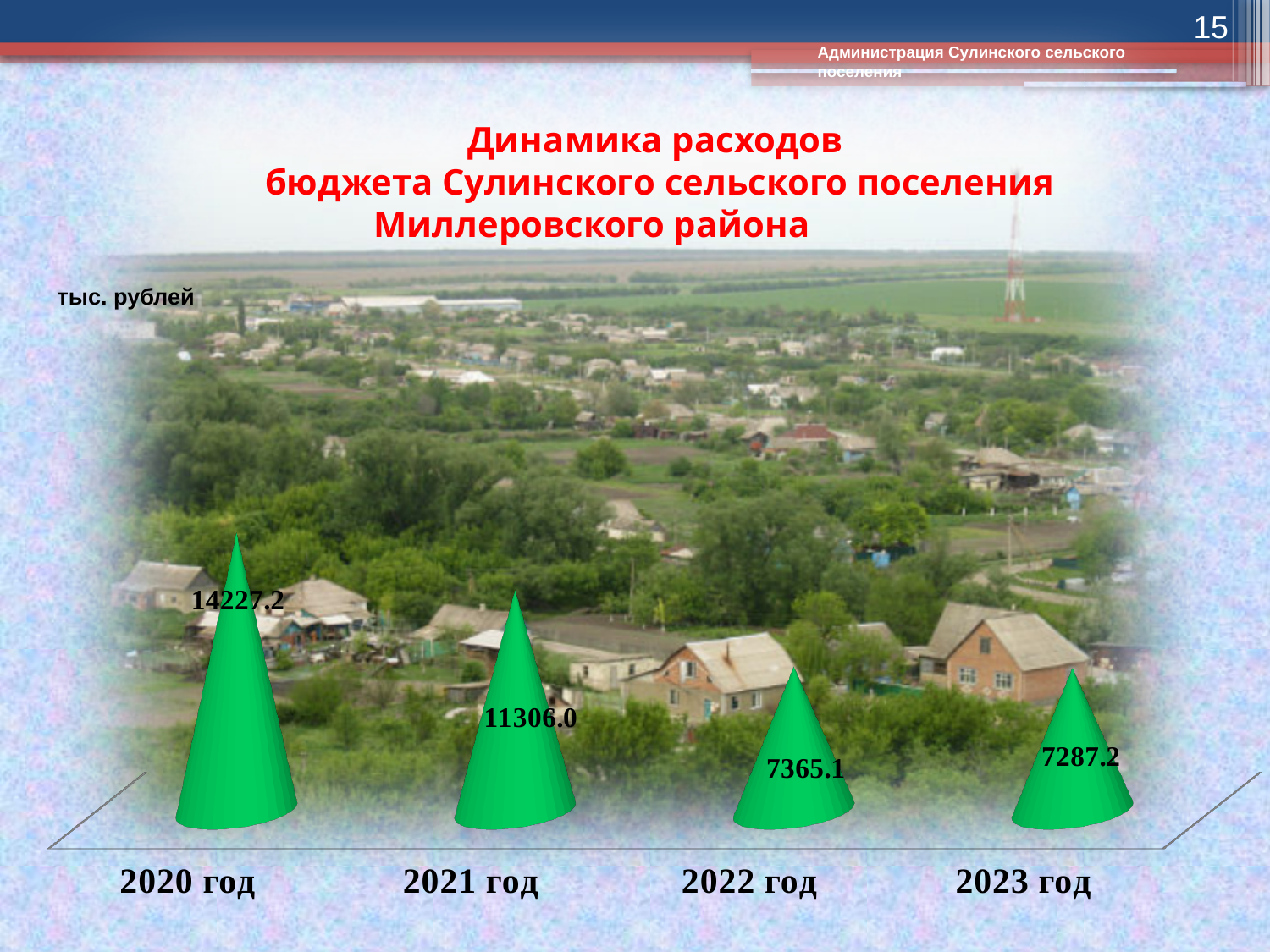
Which is larger, the value for 2022 год or the value for 2023 год? 2022 год What is the value for 2023 год? 7287.2 What is the difference between the values for 2020 год and 2021 год? 2921.2 What is the value for 2020 год? 14227.2 What is the value for 2022 год? 7365.1 Which year has the highest value? 2020 год What is the difference between the values for 2020 год and 2023 год? 6940.0 Which year has the lowest value? 2023 год Do the values rise or fall from 2020 год to 2023 год? fall What is the value for 2021 год? 11306.0 In what units are the values on the chart expressed? тыс. рублей How many years are shown on the chart? 4